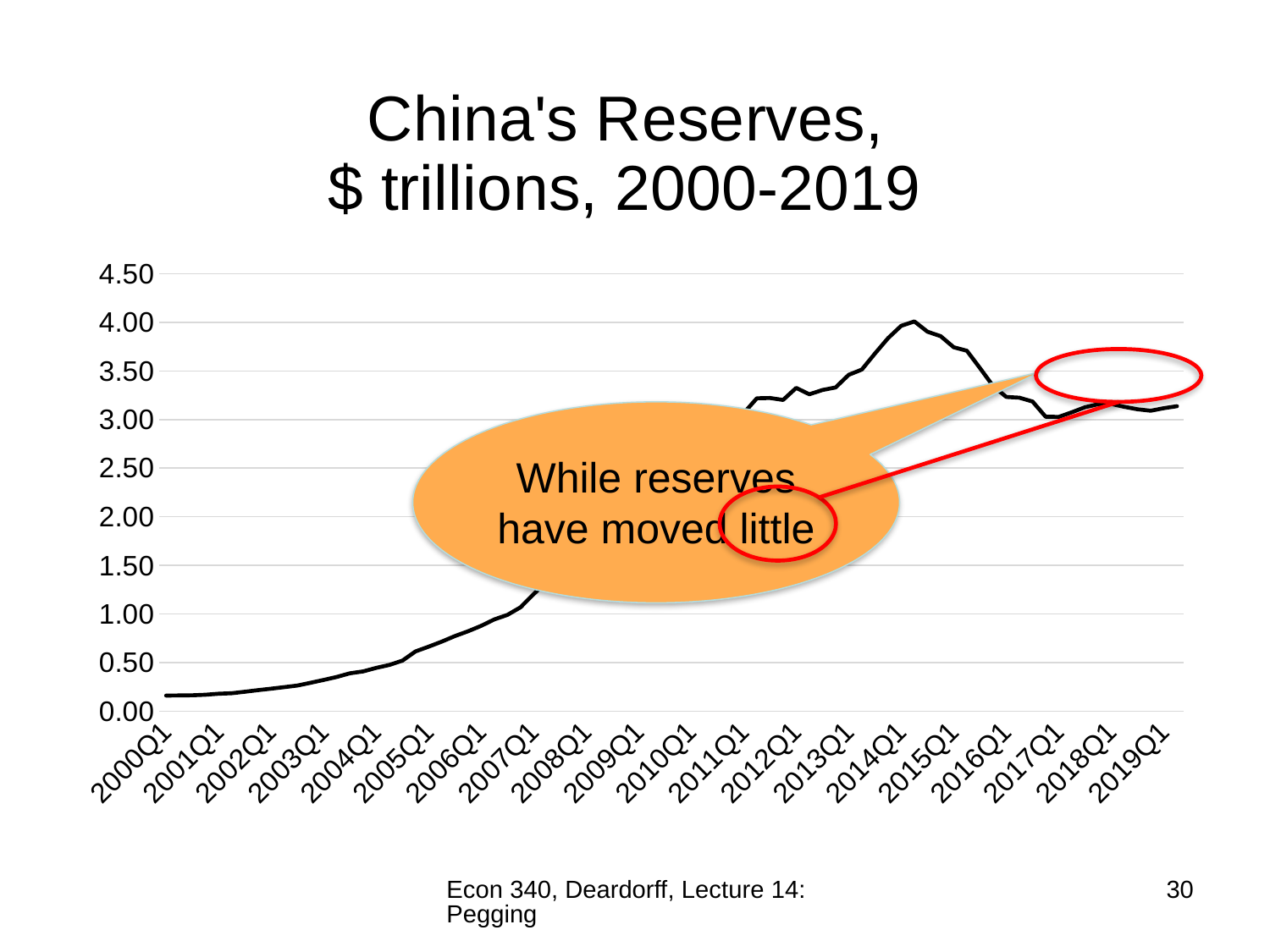
Do the values rise or fall from 2000Q1 to 2014Q1? rise Is the value for 2019Q1 greater or less than 3.50? less What kind of chart is shown on the slide? Line chart Is the value for 2000Q1 greater or less than 0.50? less Is the value for 2014Q1 greater or less than 3.50? greater Which is larger, the value for 2014Q1 or the value for 2019Q1? 2014Q1 What is the title of the chart? China's Reserves, $ trillions, 2000-2019 How many year labels are shown along the x axis? 20 In which year does the line reach its highest point? 2014 What is the highest value shown on the y axis? 4.50